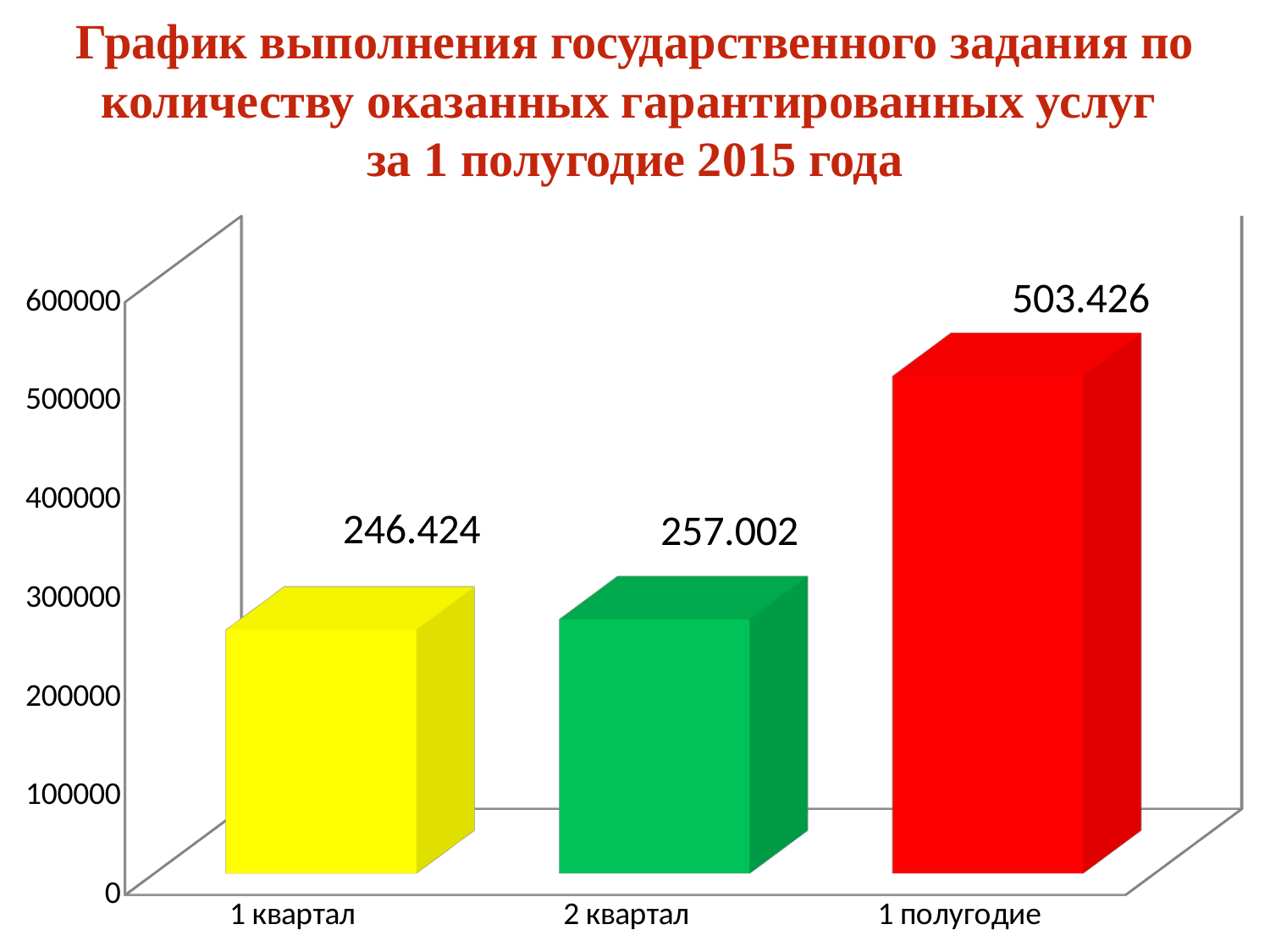
What is the difference between the values for 2 квартал and 1 квартал? 10.578 What kind of chart is shown on the slide? bar chart What is the value for 1 полугодие? 503.426 What is the value for 1 квартал? 246.424 What is the difference between the values for 1 полугодие and 2 квартал? 246.424 Which is larger, the value for 1 квартал or the value for 1 полугодие? 1 полугодие How many categories are shown on the x axis? 3 Which category has the lowest value? 1 квартал Which category has the highest value? 1 полугодие Is the value for 1 полугодие greater or less than 500000? greater What colour is the bar for 2 квартал? green What is the value for 2 квартал? 257.002